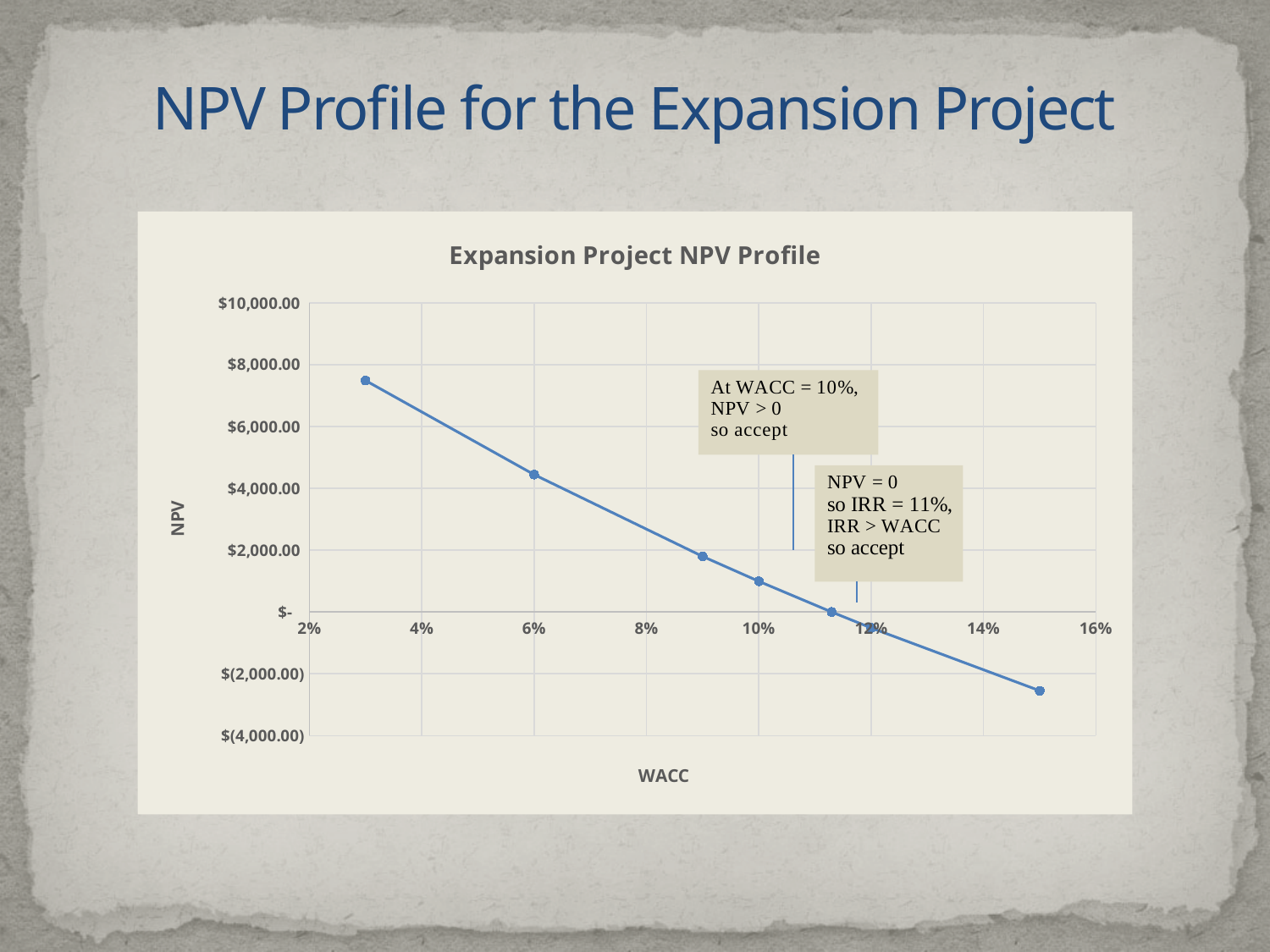
Which is larger, the NPV at WACC = 6% or the NPV at WACC = 9%? NPV at WACC = 6% According to the annotation, at what WACC does NPV equal zero (the IRR)? 11% Is the NPV at the last plotted point (WACC about 15%) greater or less than $(2,000.00)? less What is the title of the chart? Expansion Project NPV Profile Which plotted point has the highest NPV, the one at the lowest WACC or the one at the highest WACC? the one at the lowest WACC Does NPV rise or fall as WACC increases along the x axis? fall How many data points are plotted on the line? 7 Is the NPV at WACC = 10% greater or less than $2,000.00? less What is the label of the x axis? WACC What kind of chart is shown on the slide? line chart Is the NPV at the first plotted point (WACC about 3%) greater or less than $6,000.00? greater